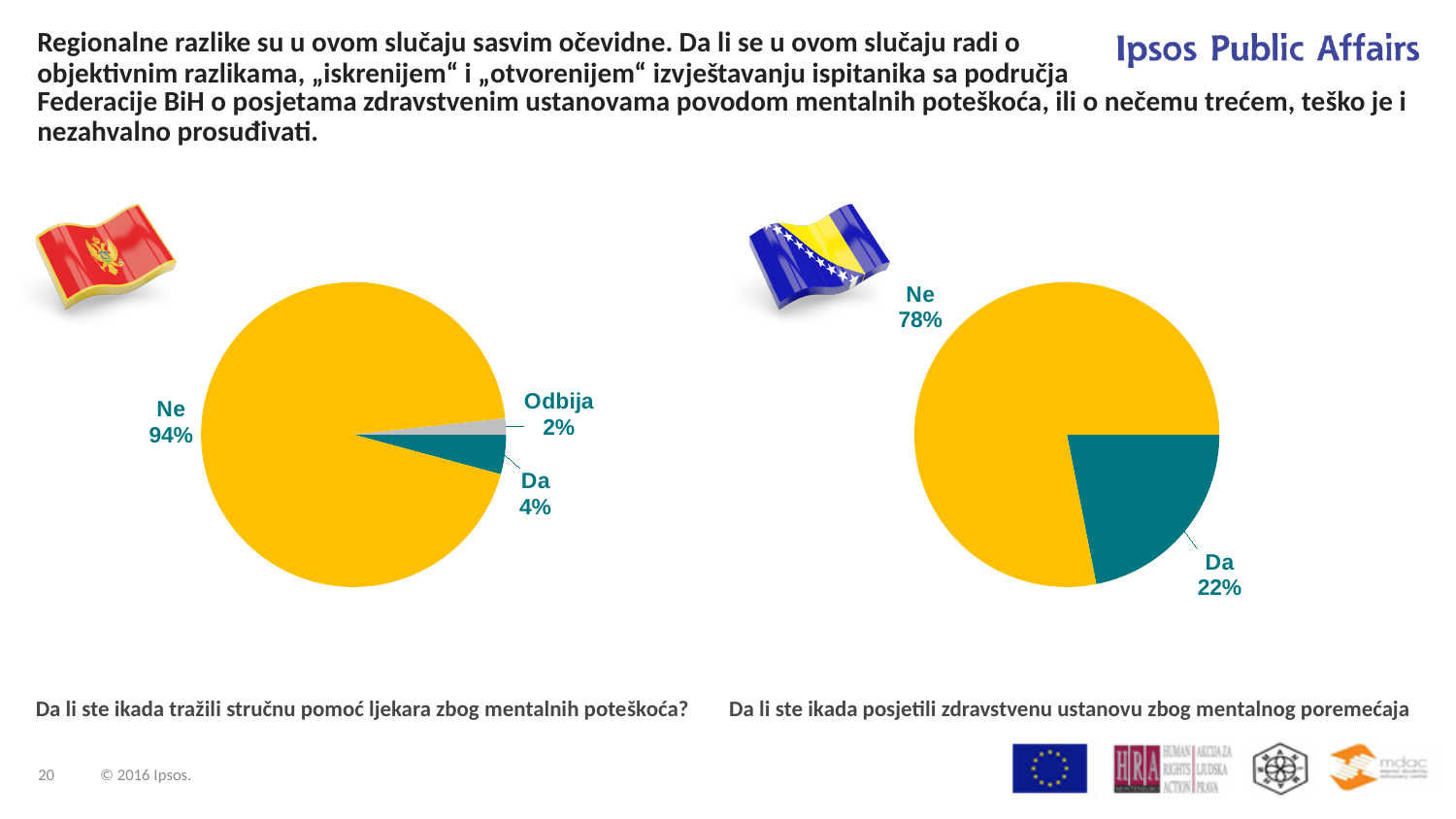
In the pie chart on the left of the slide, which category has the largest share? Ne Which is larger: the "Da" share in the left pie chart or the "Da" share in the right pie chart? The right pie chart (22%) In the pie chart on the left of the slide, what percentage is shown for "Odbija"? 2% What is the difference between the "Ne" and "Da" shares in the pie chart on the right of the slide? 56% In the pie chart on the right of the slide, what percentage is shown for "Ne"? 78% In the pie chart on the left of the slide, what percentage is shown for "Da"? 4% How many slices does the pie chart on the left of the slide have? 3 In the pie chart on the right of the slide, which category has the smaller share? Da In the pie chart on the left of the slide, which category has the smallest share? Odbija In the pie chart on the left of the slide, what percentage is shown for "Ne"? 94% What type of chart is used on the right of the slide? Pie chart In the pie chart on the right of the slide, what percentage is shown for "Da"? 22%